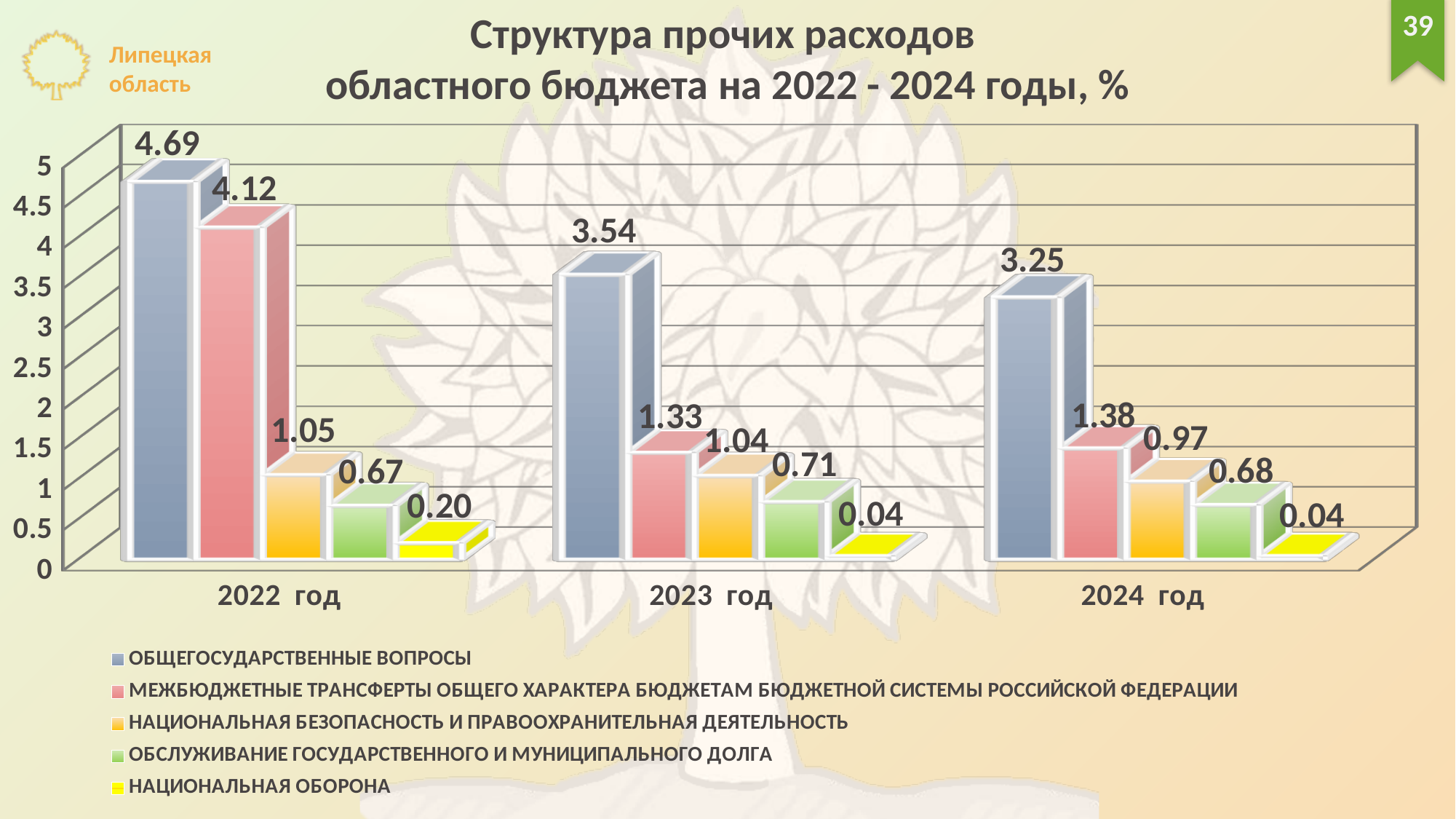
In which year is the value for ОБЩЕГОСУДАРСТВЕННЫЕ ВОПРОСЫ the highest? 2022 год How many years are shown on the x axis? 3 What is the value for ОБЩЕГОСУДАРСТВЕННЫЕ ВОПРОСЫ in 2022 год? 4.69 What is the value for НАЦИОНАЛЬНАЯ ОБОРОНА in 2024 год? 0.04 What kind of chart is shown on the slide? bar chart Which series has the lowest value in 2023 год? НАЦИОНАЛЬНАЯ ОБОРОНА Does the value for МЕЖБЮДЖЕТНЫЕ ТРАНСФЕРТЫ ОБЩЕГО ХАРАКТЕРА БЮДЖЕТАМ БЮДЖЕТНОЙ СИСТЕМЫ РОССИЙСКОЙ ФЕДЕРАЦИИ rise or fall from 2022 год to 2023 год? fall How many series does the legend list? 5 What is the difference between the values for ОБЩЕГОСУДАРСТВЕННЫЕ ВОПРОСЫ in 2022 год and 2024 год? 1.44 What is the value for ОБСЛУЖИВАНИЕ ГОСУДАРСТВЕННОГО И МУНИЦИПАЛЬНОГО ДОЛГА in 2022 год? 0.67 What is the value for МЕЖБЮДЖЕТНЫЕ ТРАНСФЕРТЫ ОБЩЕГО ХАРАКТЕРА БЮДЖЕТАМ БЮДЖЕТНОЙ СИСТЕМЫ РОССИЙСКОЙ ФЕДЕРАЦИИ in 2023 год? 1.33 Which is larger: НАЦИОНАЛЬНАЯ БЕЗОПАСНОСТЬ И ПРАВООХРАНИТЕЛЬНАЯ ДЕЯТЕЛЬНОСТЬ in 2022 год or in 2024 год? 2022 год